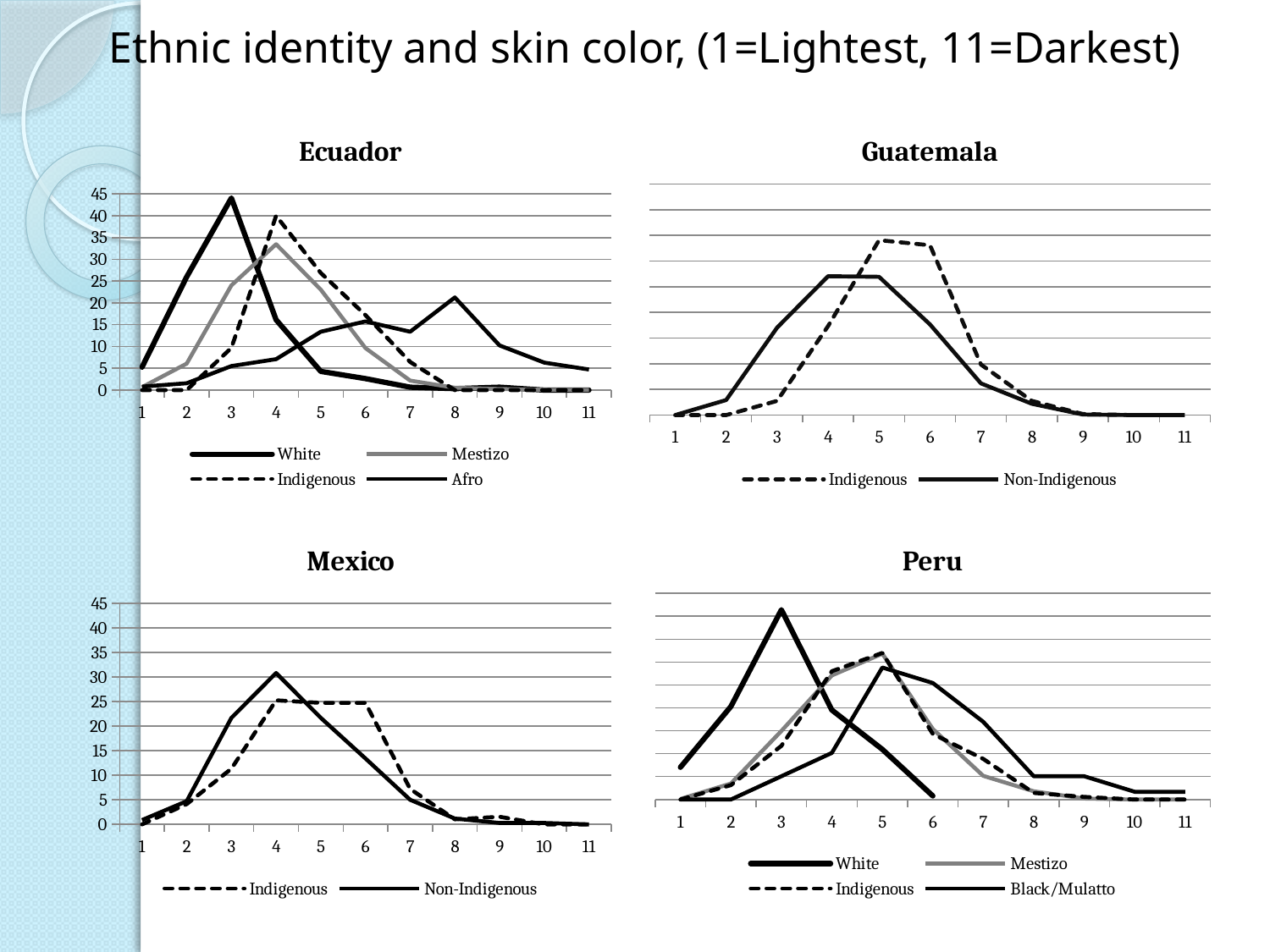
In the Peru chart, which series has the highest peak? White In the Ecuador chart, at which skin color value does the White series reach its peak? 3 What kind of chart is the Ecuador chart? line chart In the Guatemala chart, which series reaches a higher peak, Indigenous or Non-Indigenous? Indigenous In the Ecuador chart, is the value for Afro at skin color 8 greater or less than 25? less In the Ecuador chart, which series has the highest peak? White How many series does the legend of the Guatemala chart list? 2 In the Mexico chart, is the value for Non-Indigenous at skin color 4 greater or less than 25? greater In the Mexico chart, is the value for Indigenous at skin color 3 greater or less than 15? less How many series does the legend of the Ecuador chart list? 4 How many points are on the x axis of the Mexico chart? 11